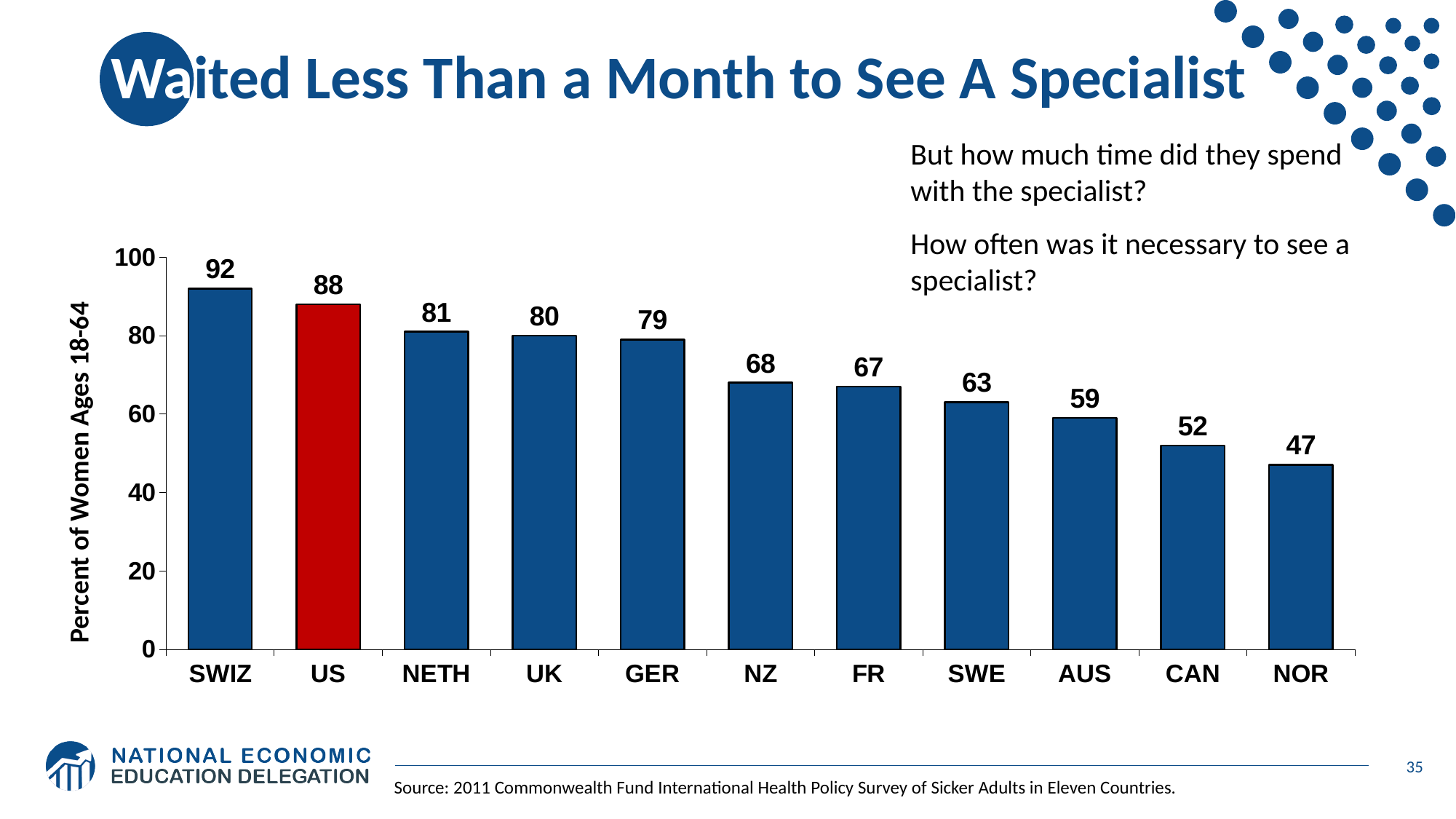
What kind of chart is shown on the slide? bar chart What is the difference between the values for SWIZ and the US? 4 How many countries are shown on the chart? 11 Is the value for FR greater or less than 60? greater What is the difference between the values for NZ and CAN? 16 What is the value for the US? 88 Which country has the highest value? SWIZ What is the value for GER? 79 Which has a larger value, SWE or AUS? SWE What is the value for NOR? 47 Which country's bar is coloured red? US Which country has the lowest value? NOR